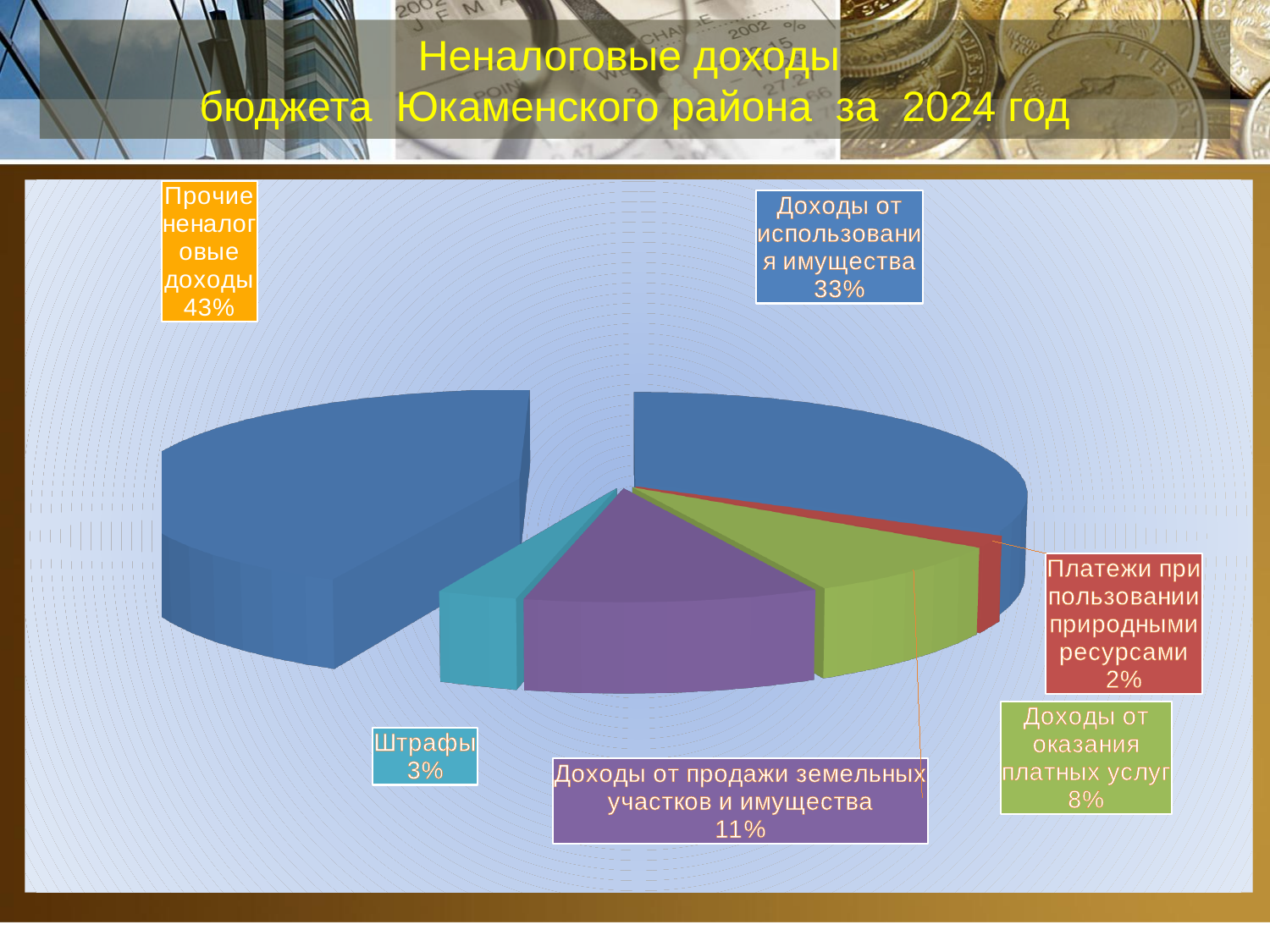
What share of the pie does "Прочие неналоговые доходы" represent? 43% What is the value shown for "Платежи при пользовании природными ресурсами"? 2% How many categories are shown in the pie chart? 6 Which category has the smallest share of the pie? Платежи при пользовании природными ресурсами What type of chart is shown on the slide? Pie chart Which is larger: the share for "Доходы от оказания платных услуг" or the share for "Штрафы"? Доходы от оказания платных услуг What is the value shown for "Штрафы"? 3% What is the value shown for "Доходы от продажи земельных участков и имущества"? 11% Which category has the largest share of the pie? Прочие неналоговые доходы What is the difference in percentage points between "Прочие неналоговые доходы" and "Доходы от использования имущества"? 10 What share of the pie does "Доходы от использования имущества" represent? 33% What is the value shown for "Доходы от оказания платных услуг"? 8%